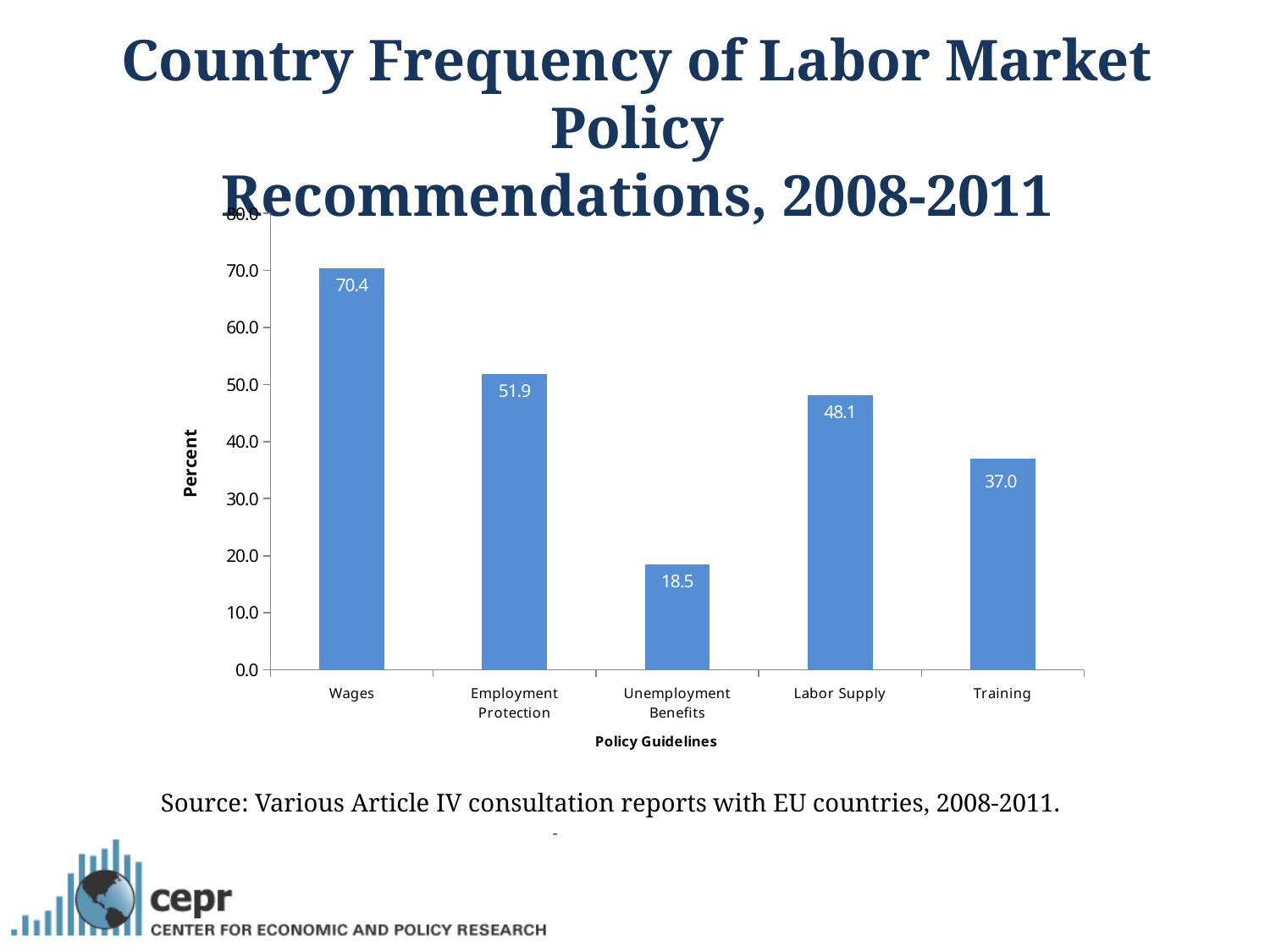
How many policy guideline categories are shown in the chart? 5 What is the difference between the values for Wages and Training? 33.4 What kind of chart is shown on the slide? Bar chart Which policy guideline has the highest value? Wages What is the label of the vertical axis? Percent Which is larger, the value for Employment Protection or the value for Labor Supply? Employment Protection What is the value for Employment Protection? 51.9 What is the value for Labor Supply? 48.1 What is the value for Training? 37.0 Which policy guideline has the lowest value? Unemployment Benefits What is the value for Wages? 70.4 What is the value for Unemployment Benefits? 18.5